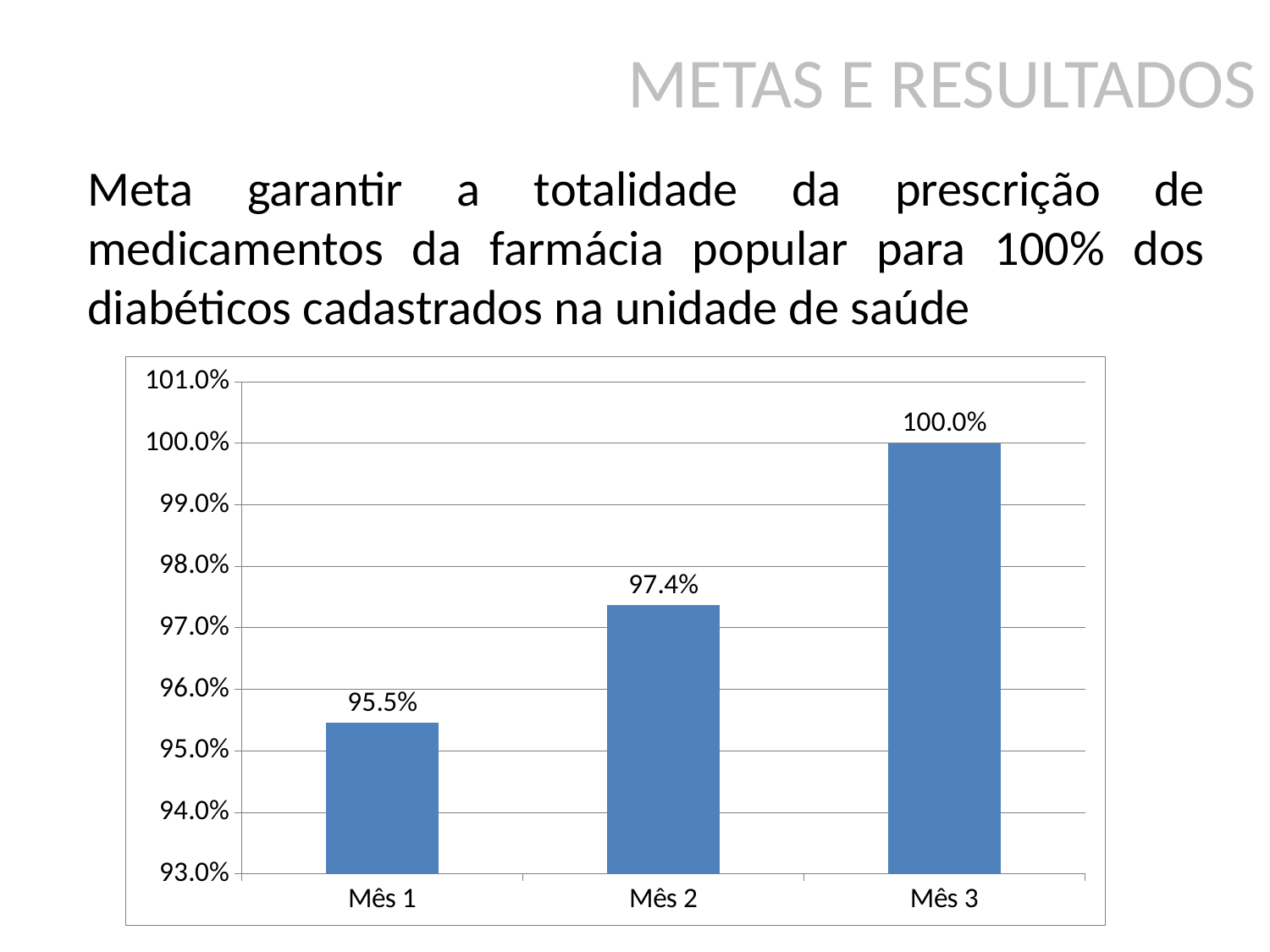
What is the value for Mês 3? 100.0% Which month has the highest value? Mês 3 Is the value for Mês 2 greater or less than 97.0%? greater What is the difference between the values for Mês 3 and Mês 1? 4.5% Do the values rise or fall from Mês 1 to Mês 3? rise Which month has the lowest value? Mês 1 How many months are shown on the x axis? 3 Which is larger, the value for Mês 2 or the value for Mês 1? Mês 2 What kind of chart is shown on the slide? bar chart What is the value for Mês 2? 97.4% What is the value for Mês 1? 95.5% What is the difference between the values for Mês 2 and Mês 1? 1.9%